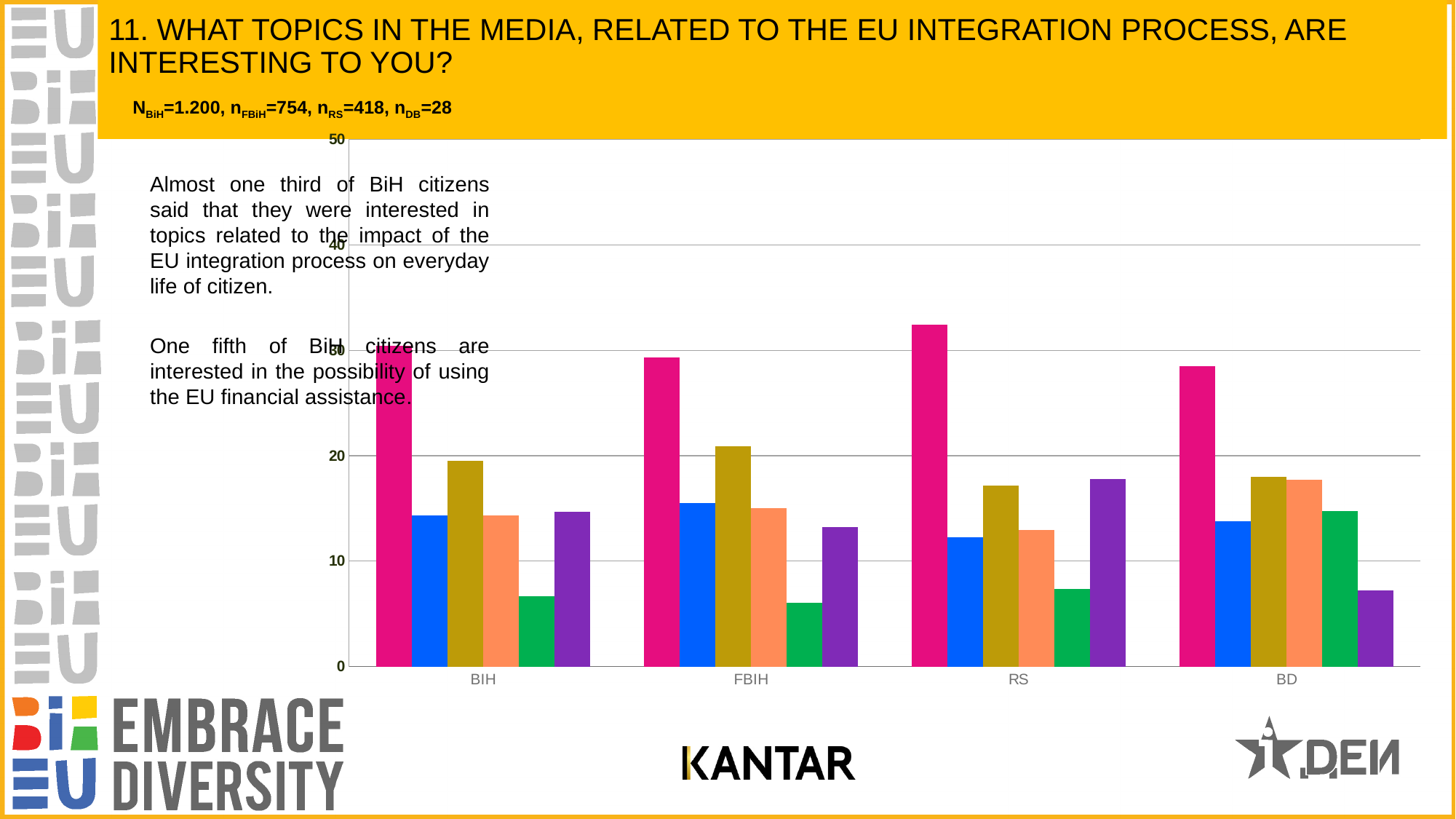
What is the highest value shown on the vertical axis of the chart? 50 In the RS category, which bar is taller: the purple bar or the green bar? purple In the BD category, which bar is taller: the green bar or the purple bar? green Is the value of the blue bar for RS greater or less than 10? greater Is the value of the pink bar for RS greater or less than 30? greater Is the value of the purple bar for BD greater or less than 10? less How many categories are shown on the x axis of the chart? 4 What kind of chart is shown on the slide? bar chart Which colour bar is the lowest in the FBIH category? green Which category has the tallest pink bar? RS